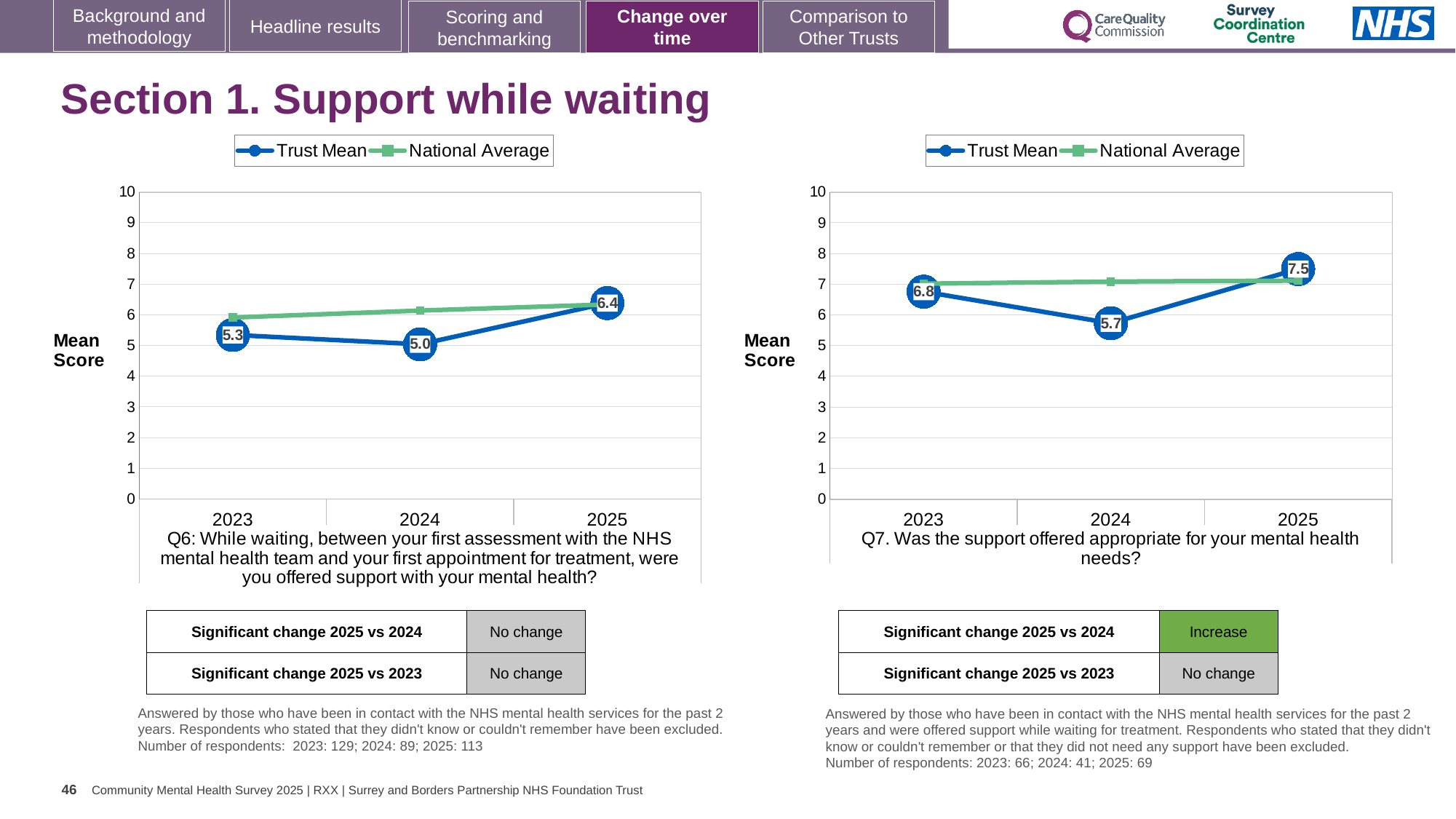
In the Q7 chart (right), is the Trust Mean for 2024 greater or less than the National Average for 2024? less In the Q6 chart (left), what is the difference between the Trust Mean for 2025 and 2023? 1.1 In the Q7 chart (right), what is the difference between the Trust Mean for 2025 and 2024? 1.8 What kind of chart is the Q6 chart (left)? Line chart In the Q7 chart (right), which year has the highest Trust Mean? 2025 In the Q6 chart (left), which year has the lowest Trust Mean? 2024 How many series does the legend of the Q7 chart (right) list? 2 In the Q7 chart (right), does the Trust Mean rise or fall from 2024 to 2025? Rise In the Q6 chart (left), what is the Trust Mean for 2024? 5.0 In the Q6 chart (left), is the National Average for 2023 greater or less than 5? greater In the Q7 chart (right), what is the Trust Mean for 2023? 6.8 In the Q6 chart (left), what is the Trust Mean for 2025? 6.4